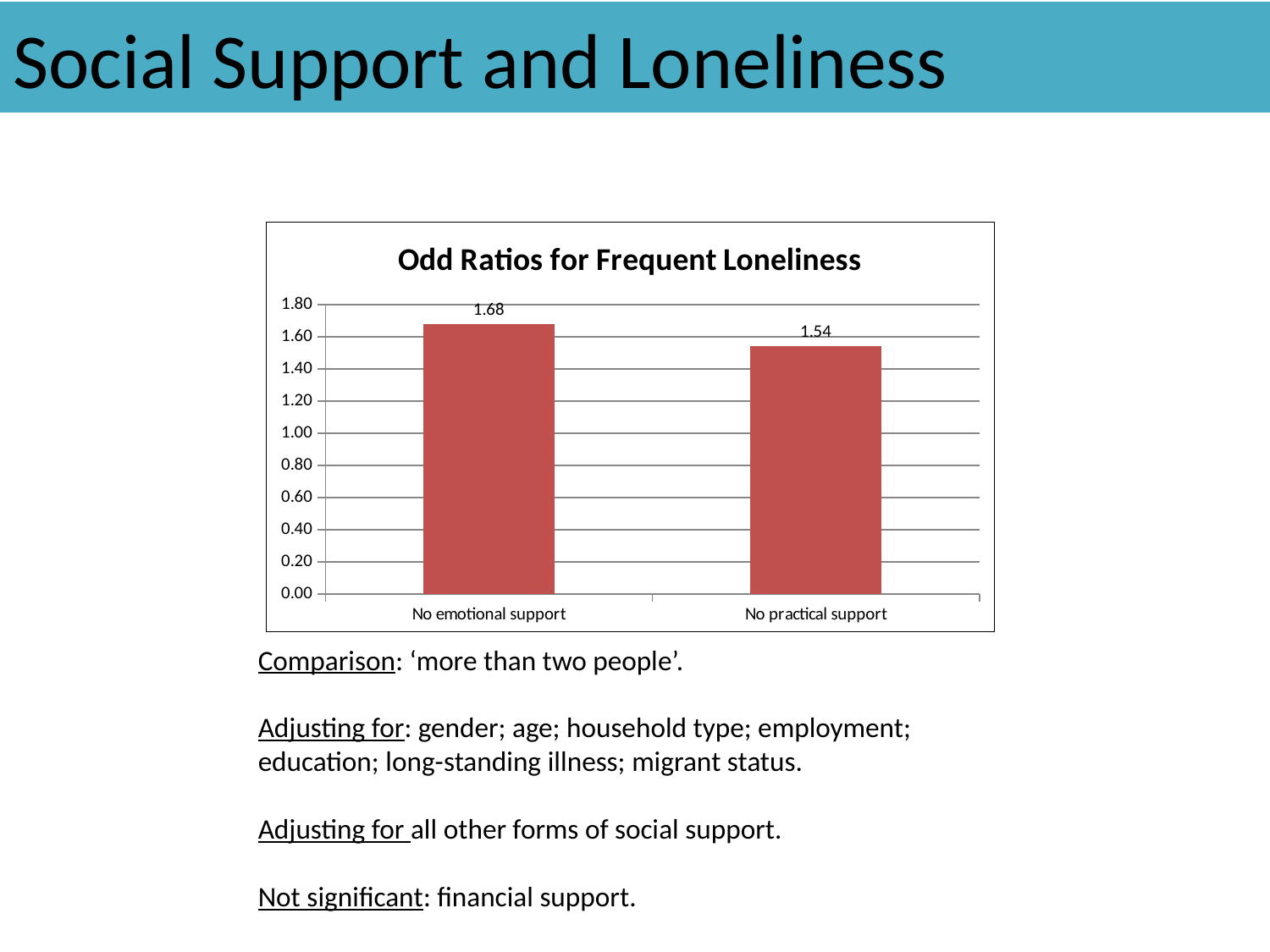
Which category has the highest odds ratio? No emotional support Which category has the lowest odds ratio? No practical support Which is larger, the odds ratio for 'No emotional support' or for 'No practical support'? No emotional support Do the values rise or fall from left to right along the x axis? Fall How many categories are shown on the x axis? 2 What is the odds ratio for 'No practical support'? 1.54 What is the odds ratio for 'No emotional support'? 1.68 What is the title of the chart? Odd Ratios for Frequent Loneliness What kind of chart is shown on the slide? Bar chart What is the difference between the odds ratios for 'No emotional support' and 'No practical support'? 0.14 Is the value for 'No emotional support' greater or less than 1.60? greater Is the value for 'No practical support' greater or less than 1.60? less